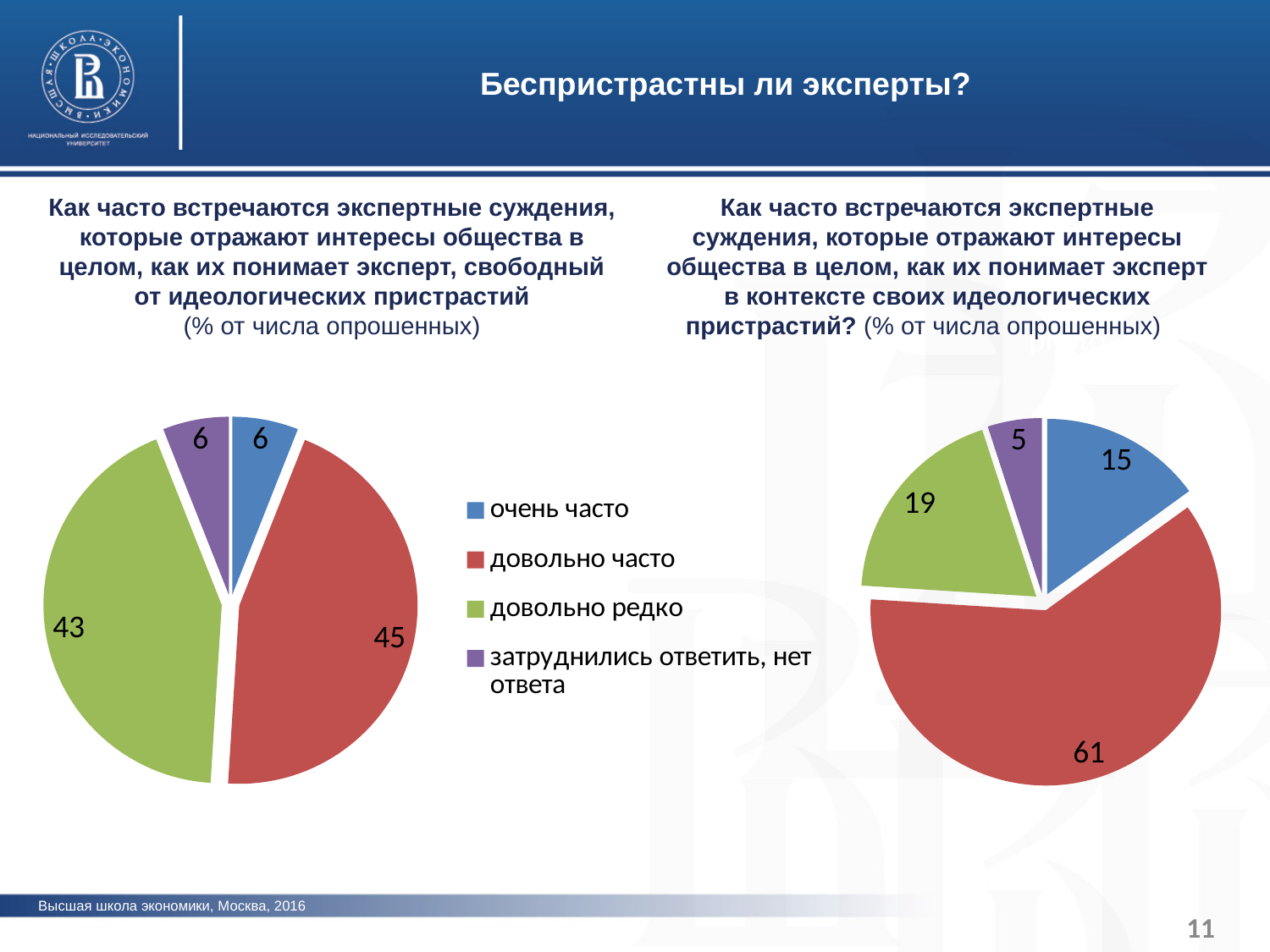
Which colour represents "довольно редко" in the legend? Green In the right pie chart, which category has the largest share? довольно часто How many slices does each pie chart have? 4 In the right pie chart (expert in the context of his ideological biases), what is the value for "очень часто"? 15 In the right pie chart, what is the difference between the values for "довольно часто" and "довольно редко"? 42 In the left pie chart, which is larger: "очень часто" or "довольно редко"? довольно редко In the left pie chart (expert free from ideological biases), what is the value for "довольно редко"? 43 In the left pie chart (expert free from ideological biases), what is the value for "довольно часто"? 45 In the right pie chart, which category has the smallest share? затруднились ответить, нет ответа What type of chart is used on this slide? Pie chart In the right pie chart (expert in the context of his ideological biases), what is the value for "довольно часто"? 61 In the left pie chart, which category has the largest share? довольно часто